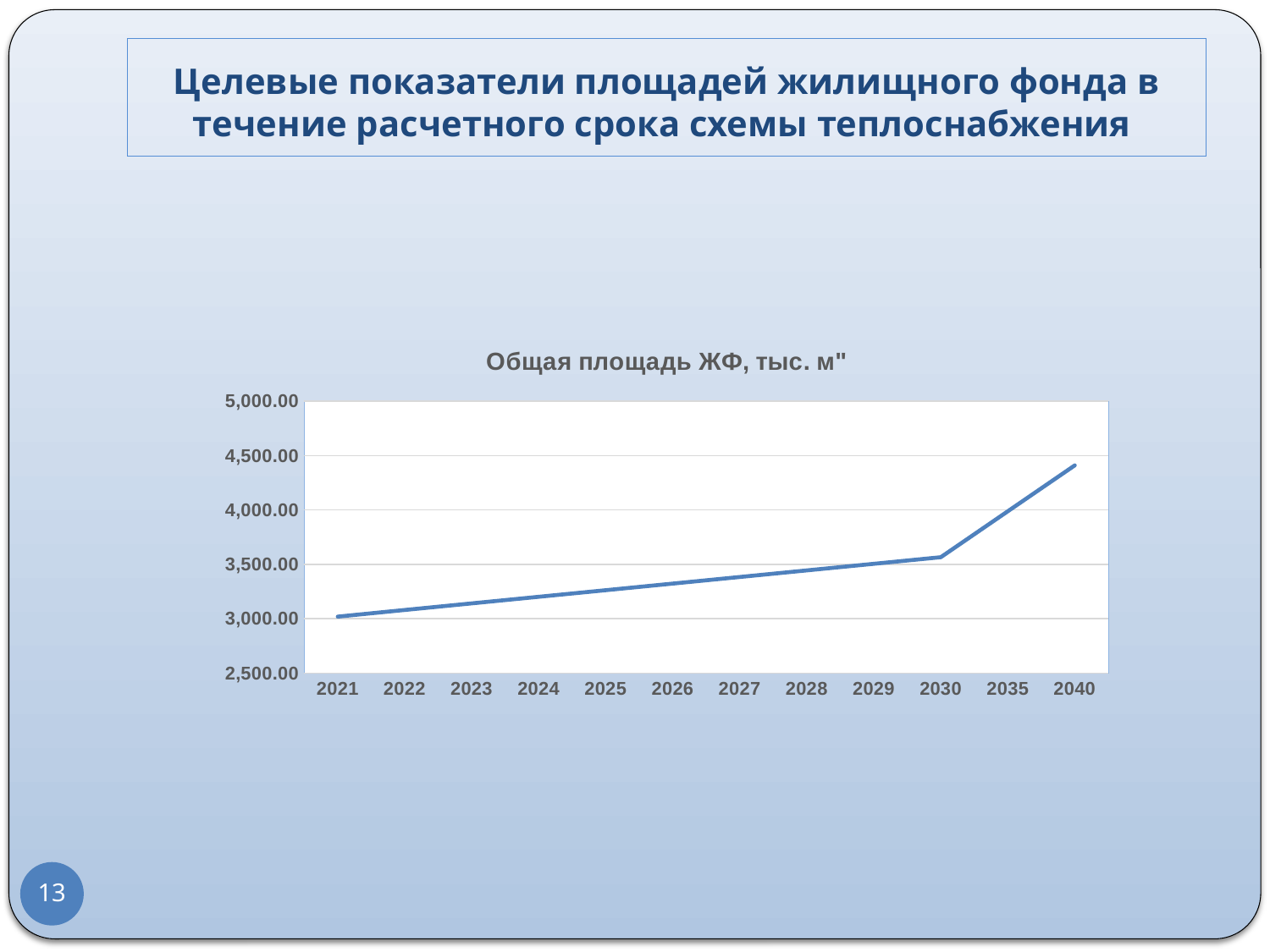
How many years are shown on the x axis of the chart? 12 Which year has the lowest value on the chart? 2021 Is the value for 2025 greater or less than 3,500.00? less What kind of chart is shown on the slide? line chart Is the value for 2040 greater or less than 4,000.00? greater Is the value for 2040 greater or less than 4,500.00? less Do the values rise or fall from 2021 to 2040? rise What is the title of the chart? Общая площадь ЖФ, тыс. м" Which is larger, the value for 2040 or the value for 2021? 2040 Which year has the highest value on the chart? 2040 Which is larger, the value for 2030 or the value for 2025? 2030